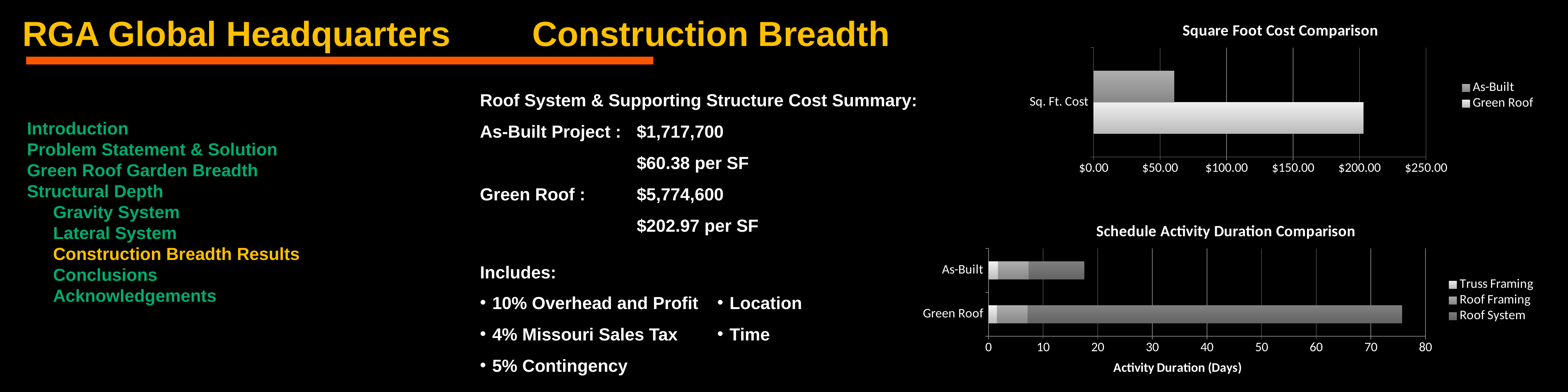
In the "Schedule Activity Duration Comparison" chart, which category has the longer total duration, As-Built or Green Roof? Green Roof How many series does the legend of the "Schedule Activity Duration Comparison" chart list? 3 What kind of chart is the "Schedule Activity Duration Comparison" chart? bar chart What kind of chart is the "Square Foot Cost Comparison" chart? bar chart In the "Schedule Activity Duration Comparison" chart, is the total duration for Green Roof greater or less than 70 days? greater In the "Square Foot Cost Comparison" chart, is the Green Roof value greater or less than $150.00? greater In the "Square Foot Cost Comparison" chart, which series has the larger Sq. Ft. Cost, As-Built or Green Roof? Green Roof In the "Schedule Activity Duration Comparison" chart, is the total duration for As-Built greater or less than 20 days? less How many series does the legend of the "Square Foot Cost Comparison" chart list? 2 What is the x-axis title of the "Schedule Activity Duration Comparison" chart? Activity Duration (Days) How many categories are shown on the "Schedule Activity Duration Comparison" chart? 2